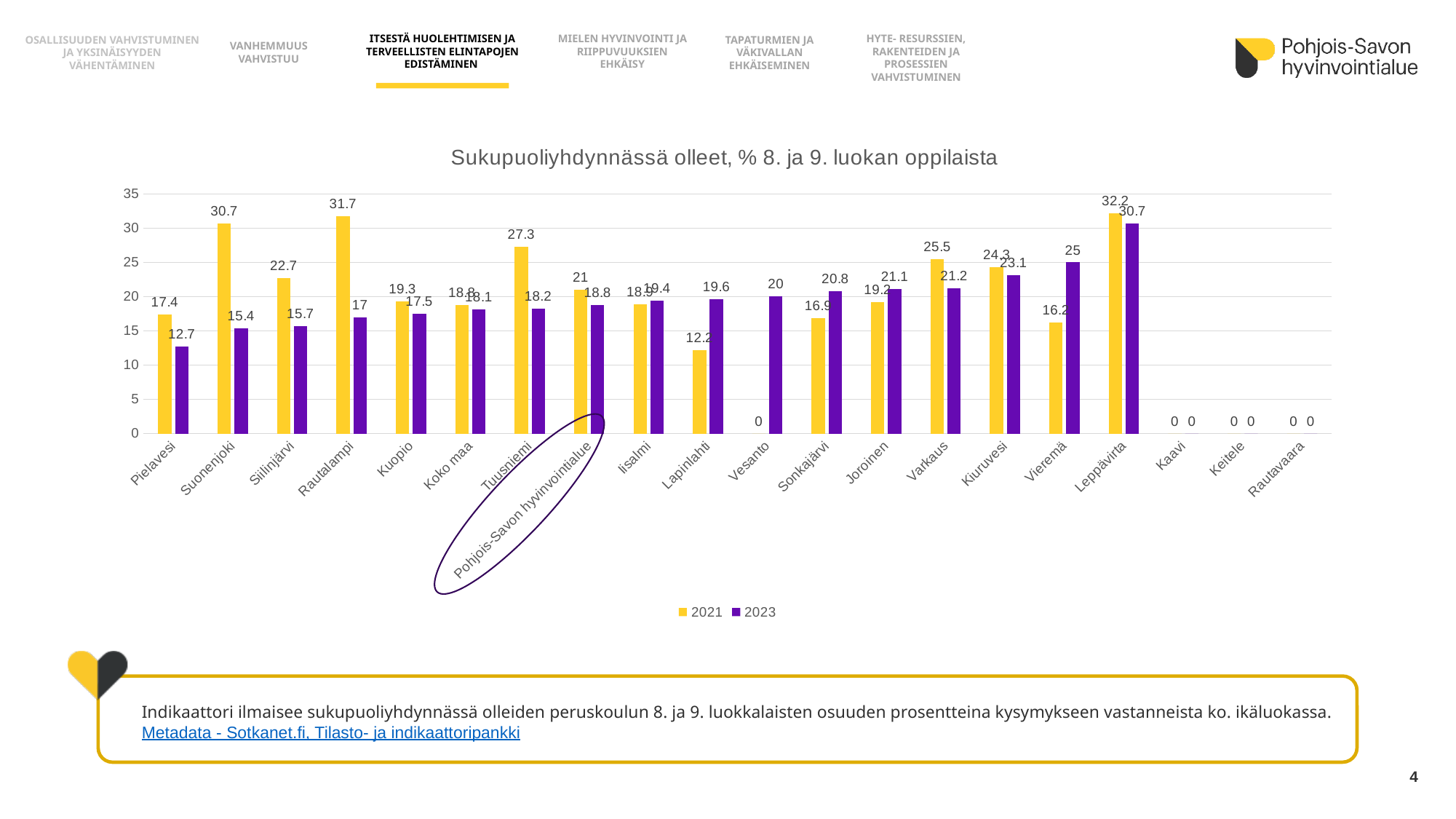
What is the difference between the 2021 and 2023 values for Rautalampi? 14.7 What type of chart is shown on the slide? Bar chart What is the 2021 value for Koko maa? 18.8 What is the 2023 value for Vieremä? 25 What is the 2021 value for Suonenjoki? 30.7 How many series does the legend list? 2 Which category has the highest 2023 value? Leppävirta Which category has the highest 2021 value? Leppävirta For Lapinlahti, which series has the larger value, 2021 or 2023? 2023 What is the difference between the 2021 and 2023 values for Leppävirta? 1.5 What is the 2023 value for Vesanto? 20 How many categories are shown on the x axis? 20